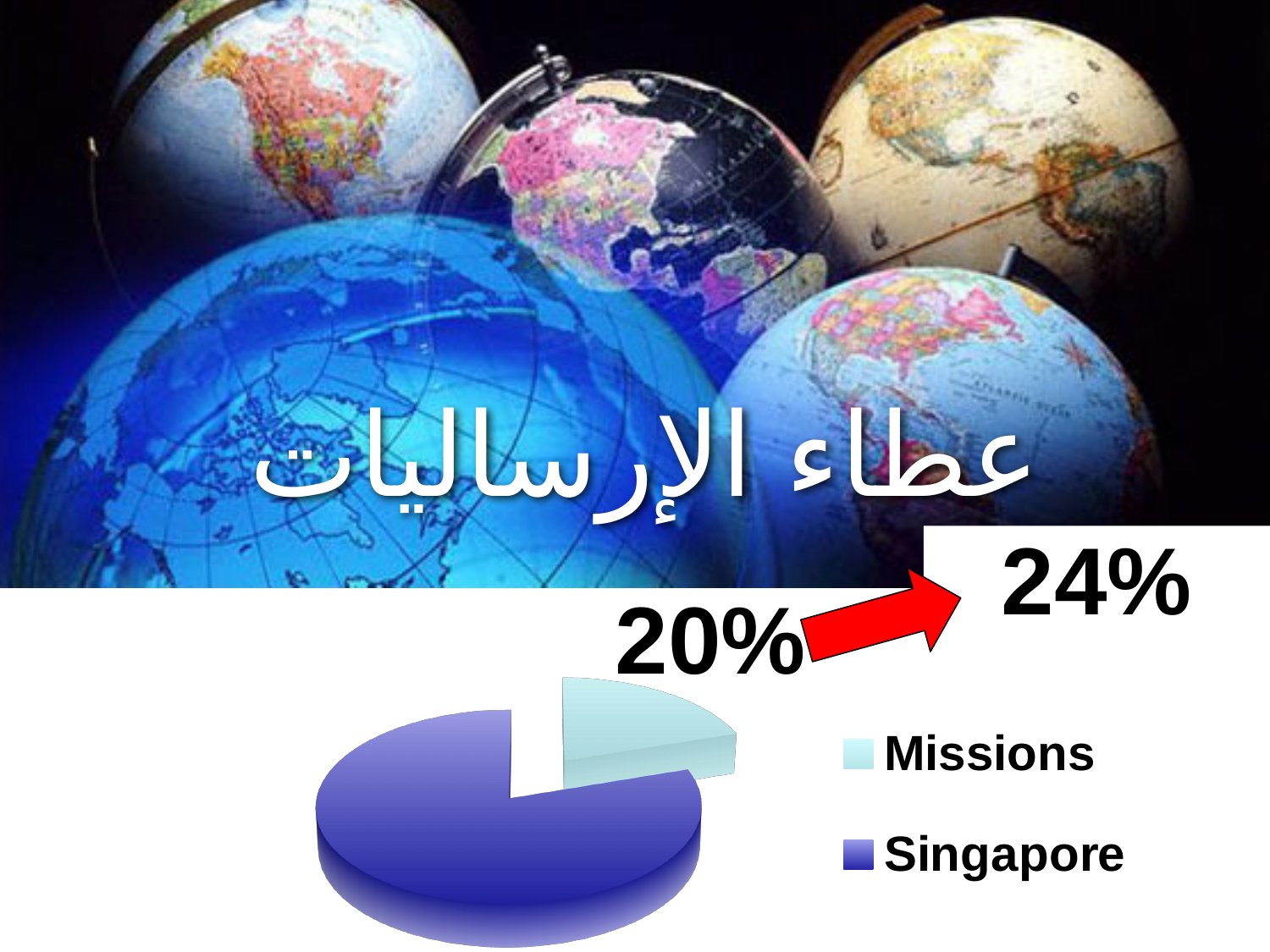
What kind of chart is shown on the slide? pie chart Is the Singapore slice greater or less than half of the pie? greater What percentage does the red arrow point to on the slide? 24% How many entries does the legend of the pie chart list? 2 What colour is the Singapore slice in the pie chart? blue Which slice of the pie chart is the smallest? Missions How many slices does the pie chart have? 2 What percentage is printed next to the Missions slice of the pie chart? 20% Which slice of the pie chart is the largest? Singapore Which slice is larger, Missions or Singapore? Singapore Is the Missions slice greater or less than half of the pie? less